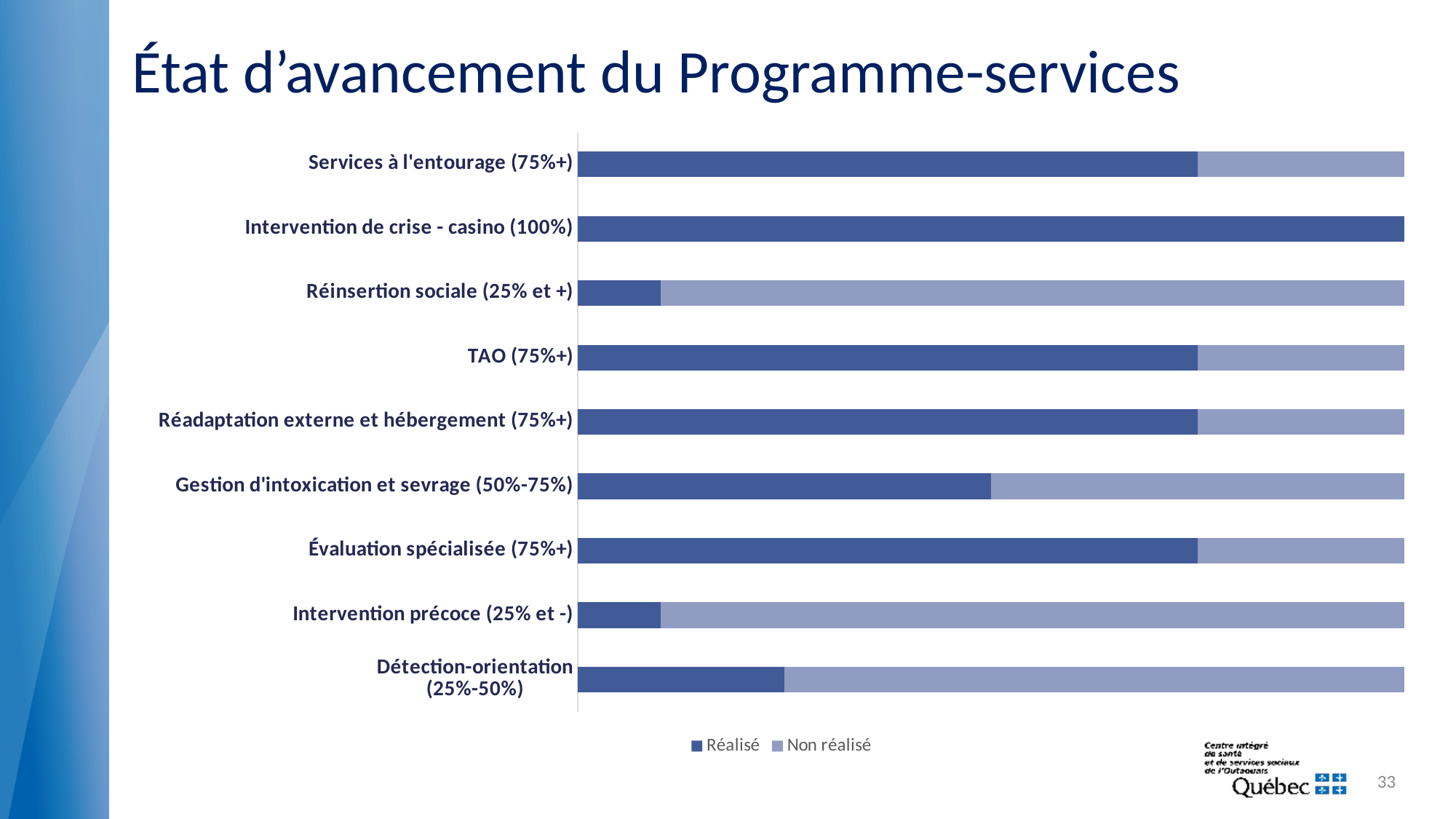
Which category is listed at the bottom of the chart? Détection-orientation (25%-50%) Is the Réalisé portion larger for Services à l'entourage (75%+) or for Intervention précoce (25% et -)? Services à l'entourage (75%+) How many series does the legend list? 2 Which category has the largest Réalisé portion? Intervention de crise - casino (100%) Which category has no Non réalisé portion at all? Intervention de crise - casino (100%) What kind of chart is shown on the slide? Stacked bar chart Is the Non réalisé portion larger for Réinsertion sociale (25% et +) or for TAO (75%+)? Réinsertion sociale (25% et +) What are the two series named in the legend? Réalisé and Non réalisé How many categories (service programmes) are plotted in the chart? 9 What is the title of the slide containing the chart? État d'avancement du Programme-services Is the Réalisé portion larger for Intervention de crise - casino (100%) or for Réinsertion sociale (25% et +)? Intervention de crise - casino (100%)